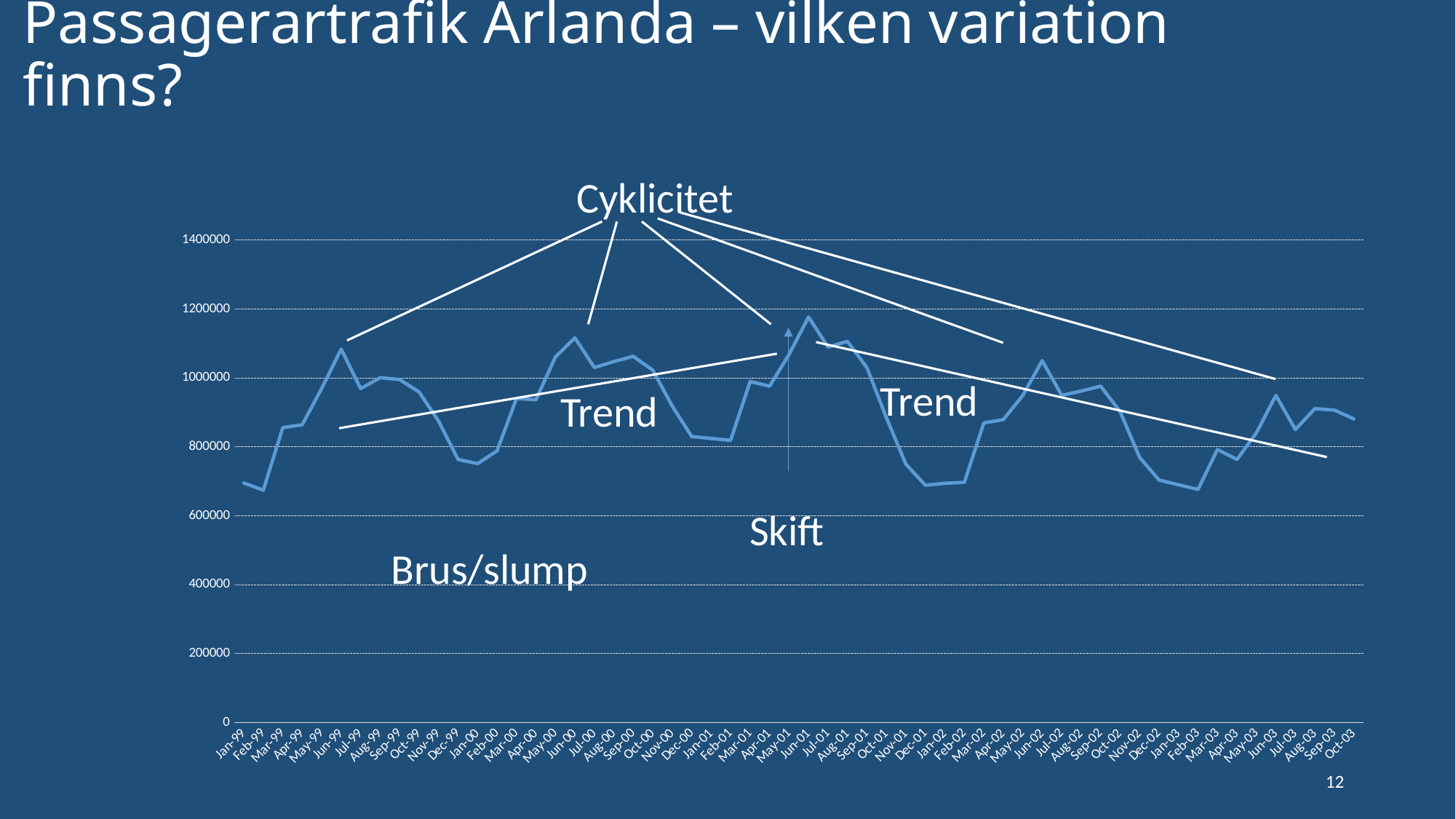
Which is larger, the value for Jun-01 or the value for Dec-01? Jun-01 Do the values rise or fall from Jan-99 to Jun-99? rise What kind of chart is shown on the slide? line chart Is the value for Jan-99 greater or less than 600000? greater Is the value for Dec-01 greater or less than 800000? less Is the value for Jun-01 greater or less than 1000000? greater Which month has the highest value on the chart? Jun-01 What is the highest value shown on the vertical axis? 1400000 What annotation label is placed near the bottom left of the chart, below the line? Brus/slump